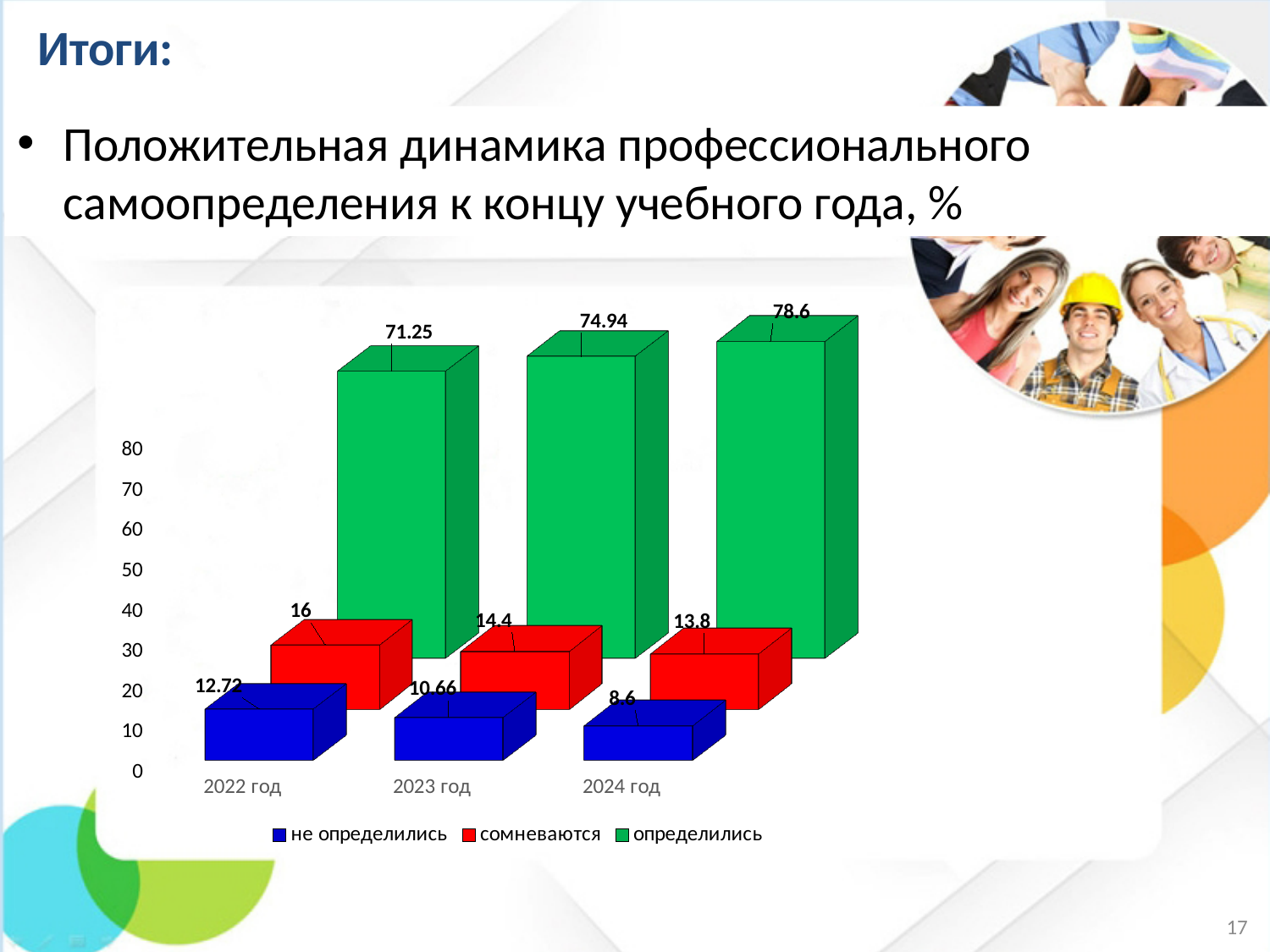
How many year categories are shown on the x axis? 3 What is the value for "не определились" in 2024 год? 8.6 Which colour represents the "определились" series? green How many series does the legend list? 3 Which is larger in 2022 год: "сомневаются" or "не определились"? сомневаются What is the value for "определились" in 2022 год? 71.25 In which year is the value for "не определились" lowest? 2024 год In which year is the value for "определились" highest? 2024 год What is the difference between the "определились" values for 2024 год and 2022 год? 7.35 Do the values for "не определились" rise or fall from 2022 год to 2024 год? fall What type of chart is shown on the slide? bar chart What is the value for "сомневаются" in 2023 год? 14.4